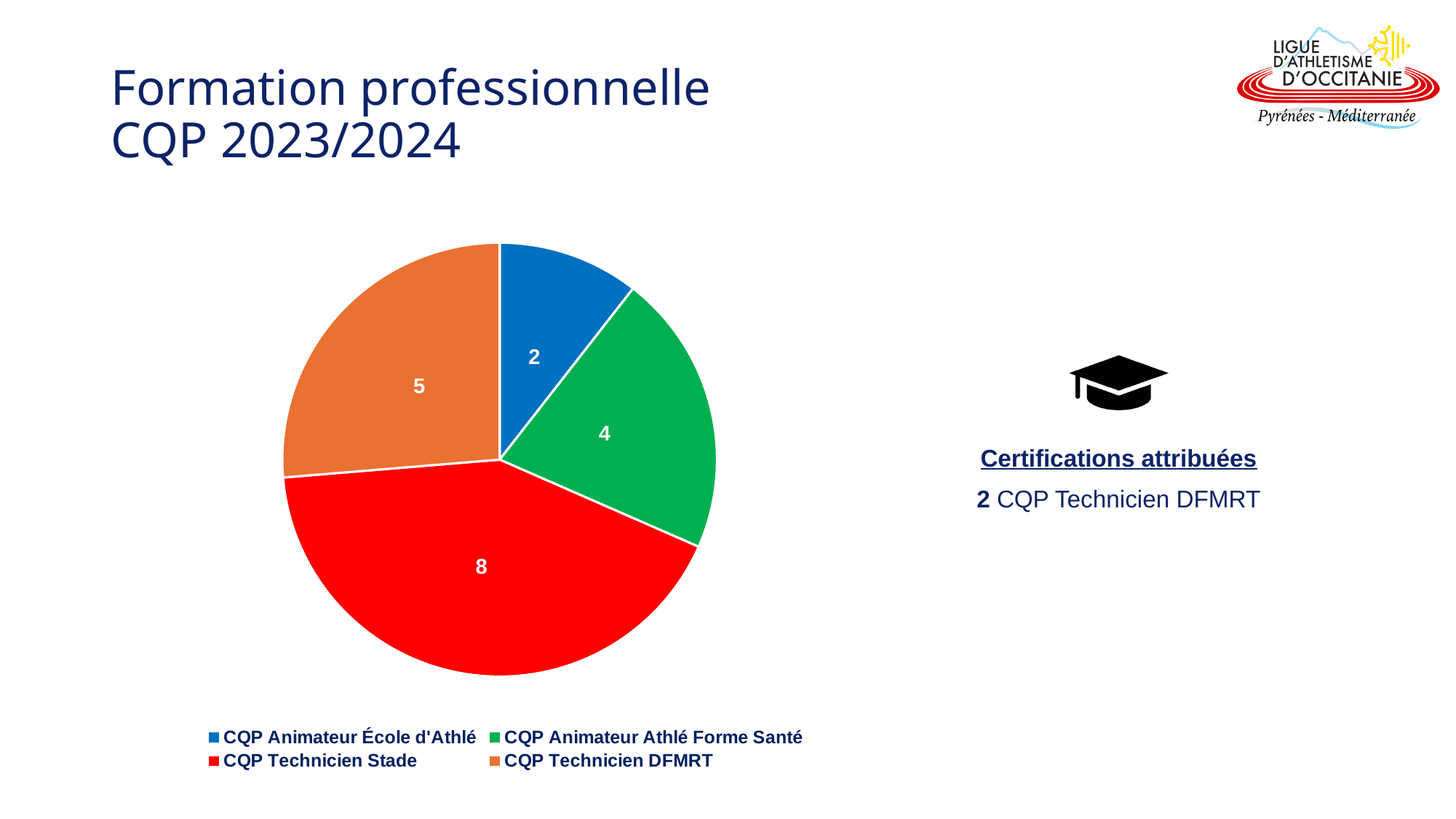
What is the difference between the values for CQP Technicien Stade and CQP Technicien DFMRT? 3 Which is larger, the value for CQP Animateur Athlé Forme Santé or the value for CQP Technicien DFMRT? CQP Technicien DFMRT What is the value for CQP Animateur Athlé Forme Santé? 4 What is the value for CQP Animateur École d'Athlé? 2 Which category has the smallest slice of the pie? CQP Animateur École d'Athlé What is the value for CQP Technicien Stade? 8 Which category has the largest slice of the pie? CQP Technicien Stade What colour is the slice for CQP Technicien Stade? red How many slices does the pie chart have? 4 What is the value for CQP Technicien DFMRT? 5 What is the total of all the slices in the pie chart? 19 What type of chart is shown on the slide? pie chart